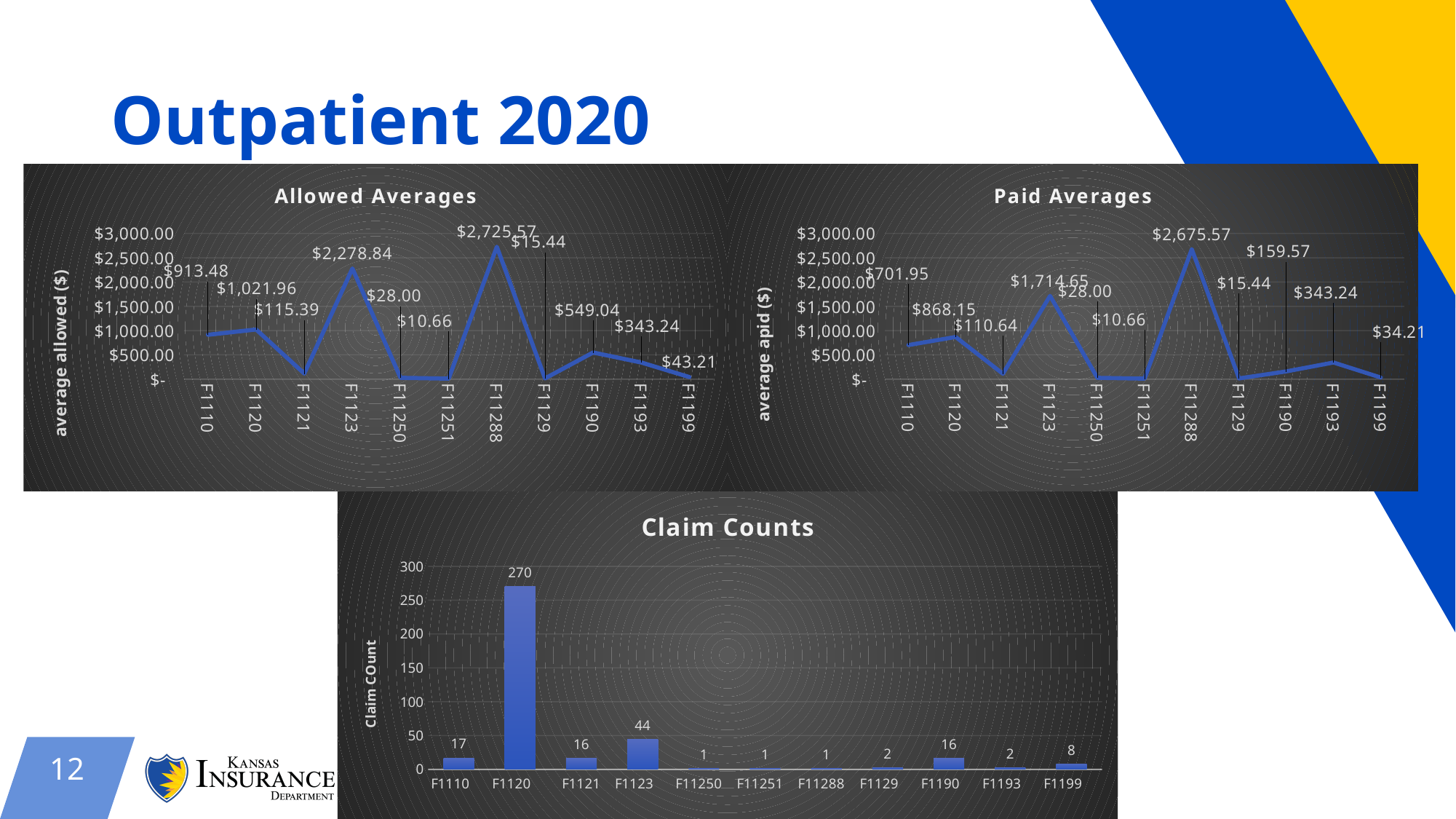
What kind of chart is the Paid Averages chart? line chart In the Allowed Averages chart, what is the value for F11288? $2,725.57 In the Claim Counts chart, what is the claim count for F1120? 270 What kind of chart is the Claim Counts chart? bar chart In the Claim Counts chart, how many categories are shown on the x axis? 11 In the Allowed Averages chart, which category has the lowest value? F11251 In the Claim Counts chart, which category has the highest claim count? F1120 In the Allowed Averages chart, which is larger, the value for F1123 or the value for F1190? F1123 In the Paid Averages chart, what is the value for F1123? $1,714.65 In the Claim Counts chart, what is the difference between the claim counts for F1123 and F1110? 27 In the Paid Averages chart, which category has the highest value? F11288 In the Paid Averages chart, what is the difference between the values for F1120 and F1110? $166.20